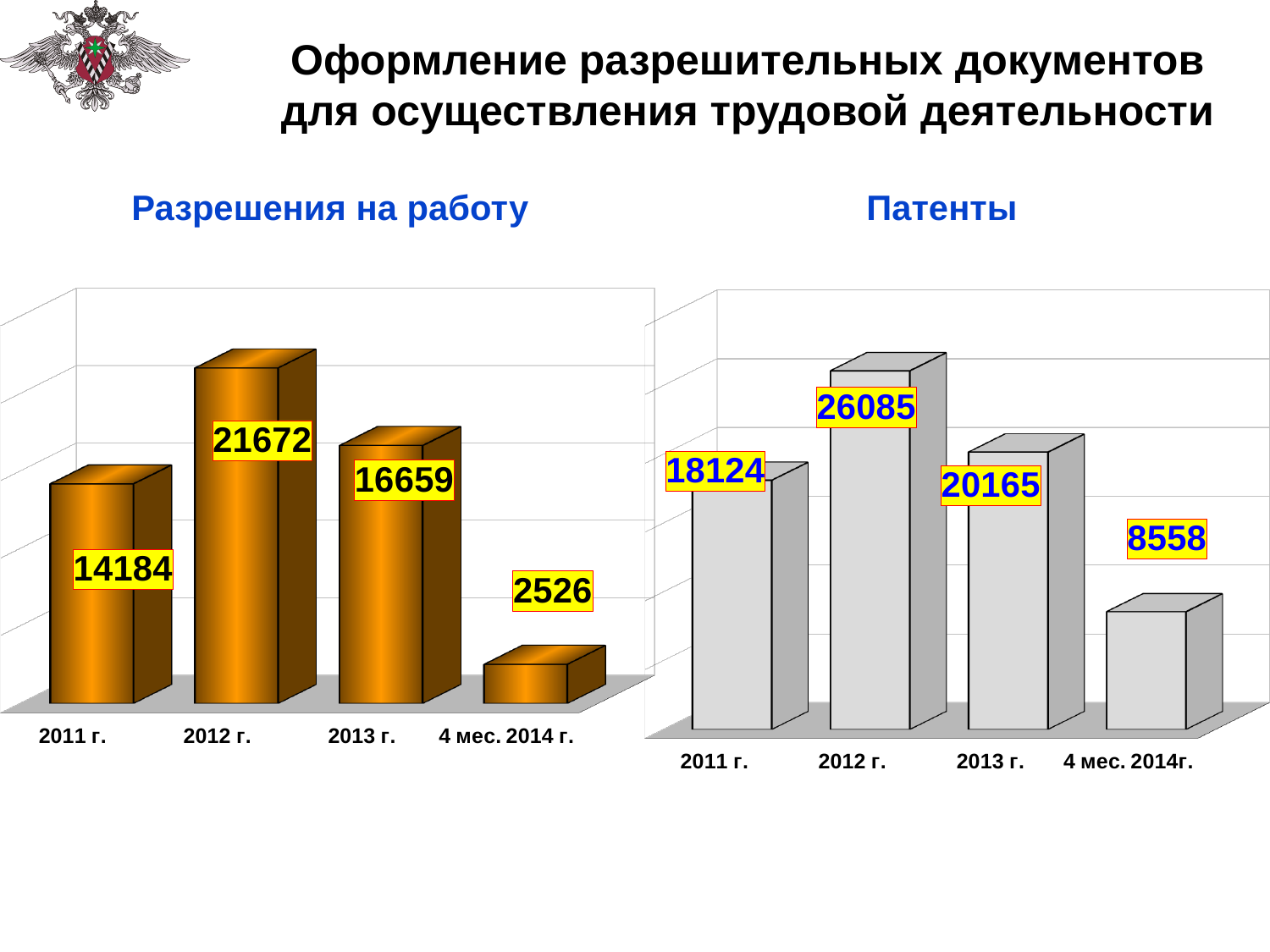
What is the value for 2011 г. in the "Разрешения на работу" chart? 14184 In the "Патенты" chart, which category has the lowest value? 4 мес. 2014г. In the "Разрешения на работу" chart, what is the difference between the values for 2012 г. and 2013 г.? 5013 In the "Разрешения на работу" chart, what is the value for 2012 г.? 21672 In the "Патенты" chart, do the values rise or fall from 2012 г. to 4 мес. 2014г.? Fall In the "Патенты" chart, what is the difference between the values for 2012 г. and 2011 г.? 7961 In the "Разрешения на работу" chart, which category has the highest value? 2012 г. How many categories are shown in the "Разрешения на работу" chart? 4 What kind of chart is the "Патенты" chart? Bar chart In the "Патенты" chart, which is larger: the value for 2011 г. or the value for 2013 г.? 2013 г. In the "Патенты" chart, what is the value for 4 мес. 2014г.? 8558 Which is larger: the 2013 г. value in the "Разрешения на работу" chart or the 2013 г. value in the "Патенты" chart? Патенты